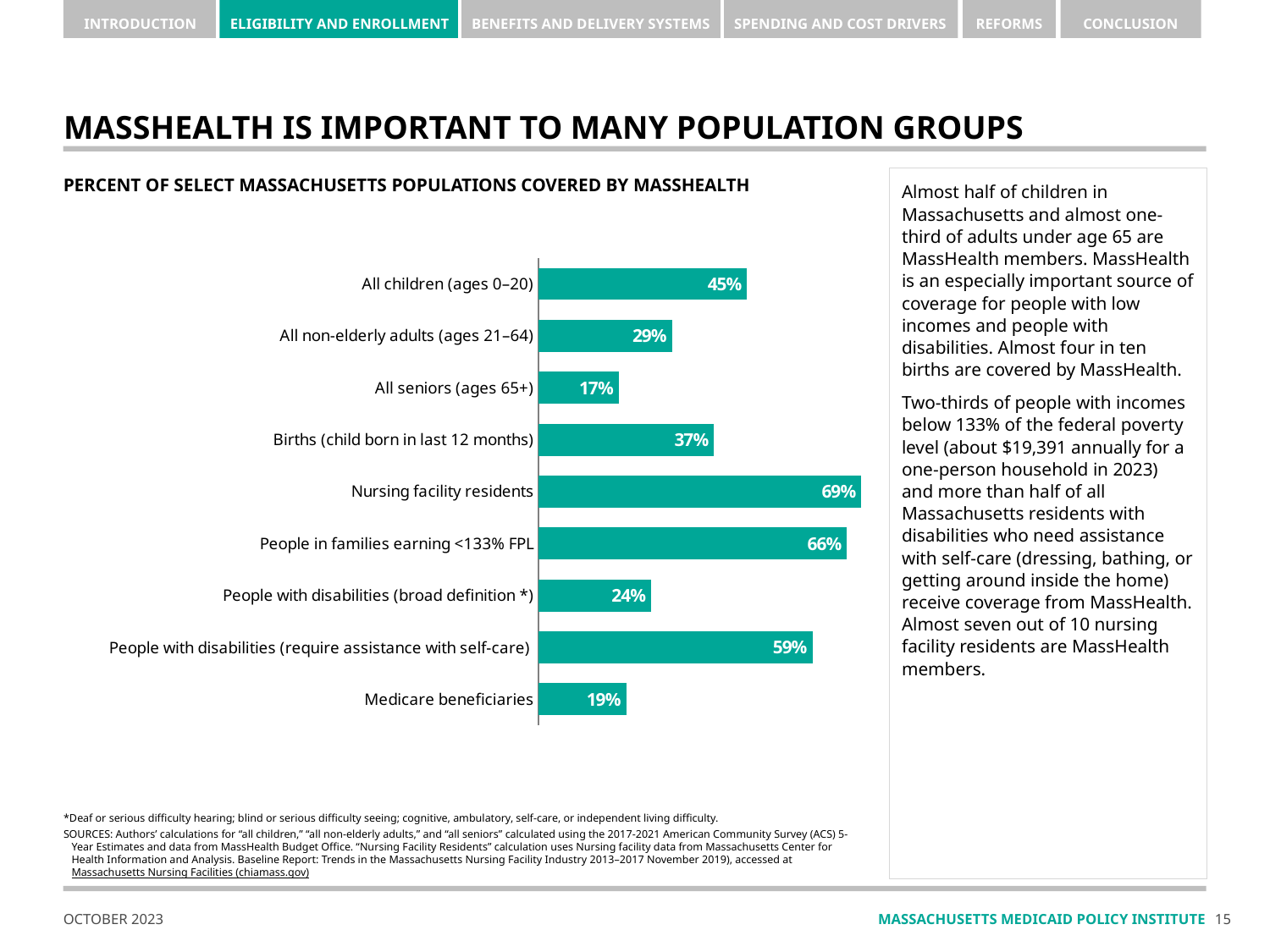
Which is larger: the percent for births (child born in last 12 months) or the percent for all non-elderly adults (ages 21–64)? Births (child born in last 12 months) Which population group has the highest percent covered by MassHealth? Nursing facility residents Which population group has the lowest percent covered by MassHealth? All seniors (ages 65+) How many population groups are shown in the chart? 9 What percent of nursing facility residents are covered by MassHealth? 69% What percent of people in families earning <133% FPL are covered by MassHealth? 66% What is the title of the chart? Percent of select Massachusetts populations covered by MassHealth What percent of Medicare beneficiaries are covered by MassHealth? 19% What percent of all children (ages 0–20) are covered by MassHealth? 45% What is the difference in percentage points between all children (ages 0–20) and all seniors (ages 65+)? 28 What is the difference in percentage points between people with disabilities (require assistance with self-care) and people with disabilities (broad definition *)? 35 What kind of chart is shown on the slide? Bar chart